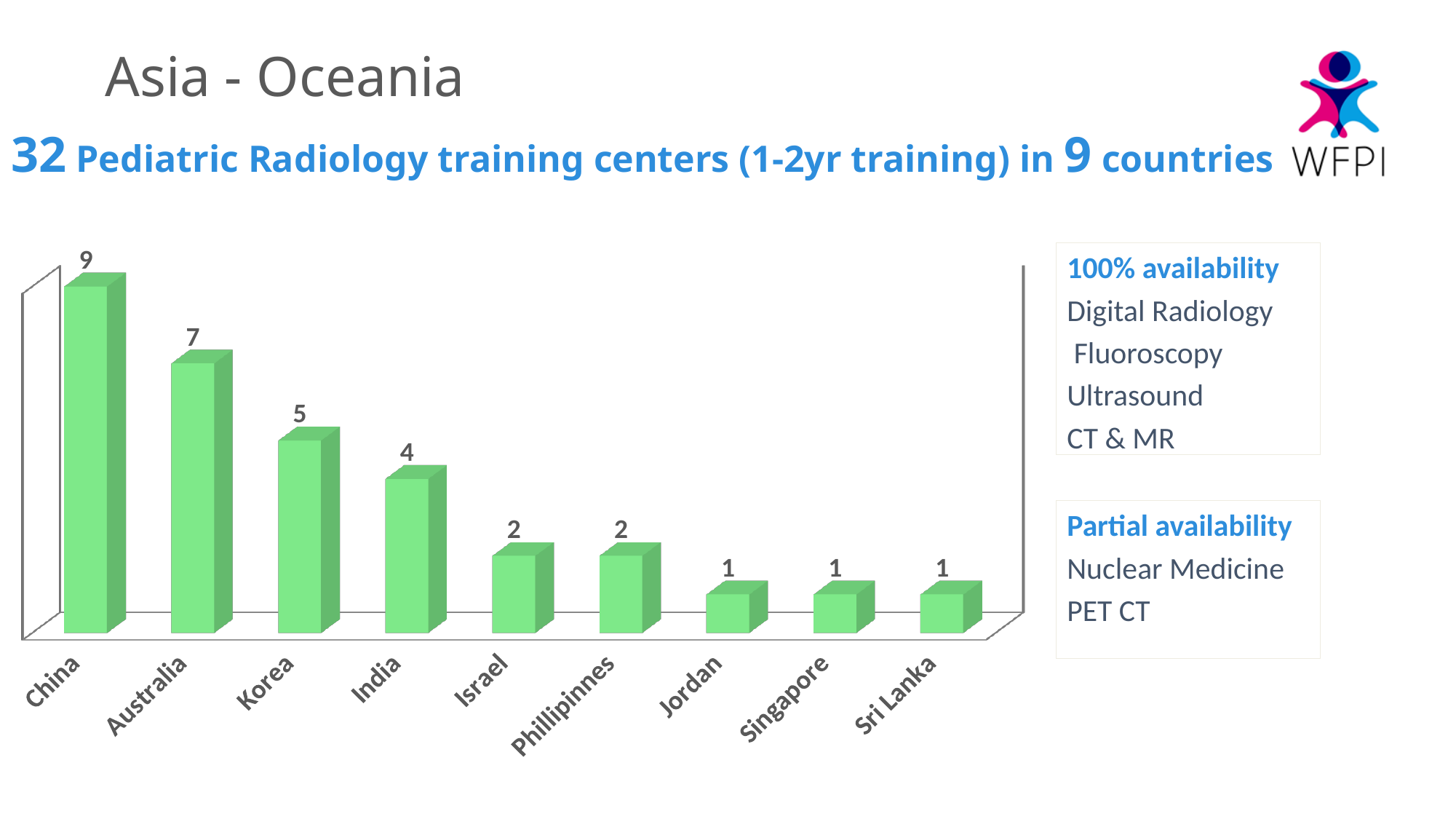
How many countries on the chart have a value of 1? 3 Do the values rise or fall from left to right along the x axis? fall Which country has the highest number of training centers? China How many countries are shown on the chart? 9 How many pediatric radiology training centers does China have? 9 What is the value shown for Australia? 7 Which has a larger value, India or Phillipinnes? India What is the value shown for Korea? 5 What is the difference between the values for China and Australia? 2 What kind of chart is shown on the slide? bar chart What is the value shown for India? 4 What is the difference between the values for Korea and Israel? 3